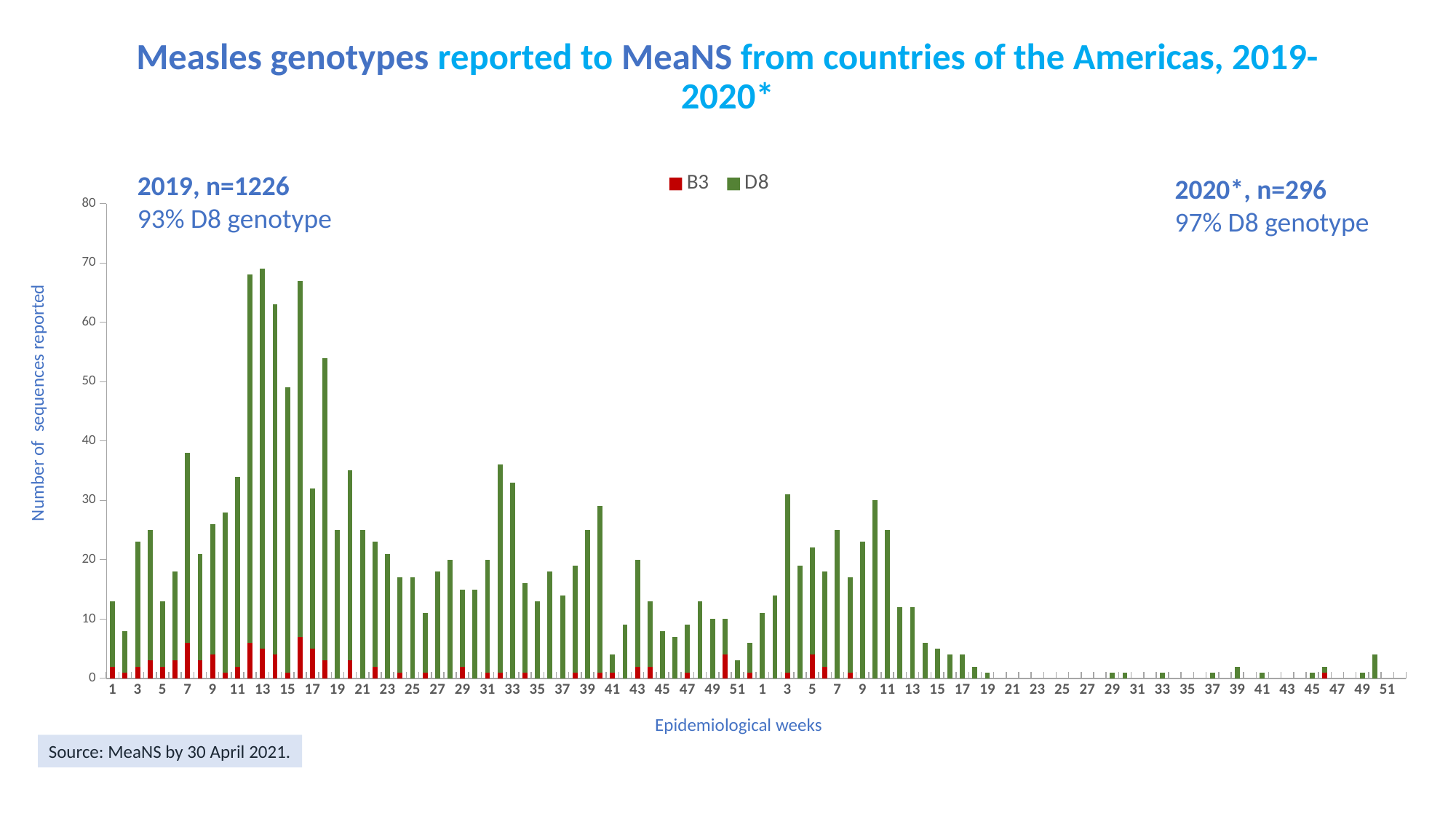
What is the label of the vertical axis? Number of sequences reported Is the value for epidemiological week 9 of 2020 greater or less than 30? less Which is larger, the value for week 7 of 2019 or the value for week 9 of 2019? week 7 of 2019 Is the value for epidemiological week 1 of 2019 greater or less than 10? greater What are the two genotypes listed in the legend? B3 and D8 Do the values rise or fall along the x axis from week 13 to week 19 of 2020? fall Is the value for epidemiological week 13 of 2019 greater or less than 60? greater How many series does the legend list? 2 Which is larger, the value for week 13 of 2019 or the value for week 3 of 2020? week 13 of 2019 What kind of chart is shown on the slide? bar chart